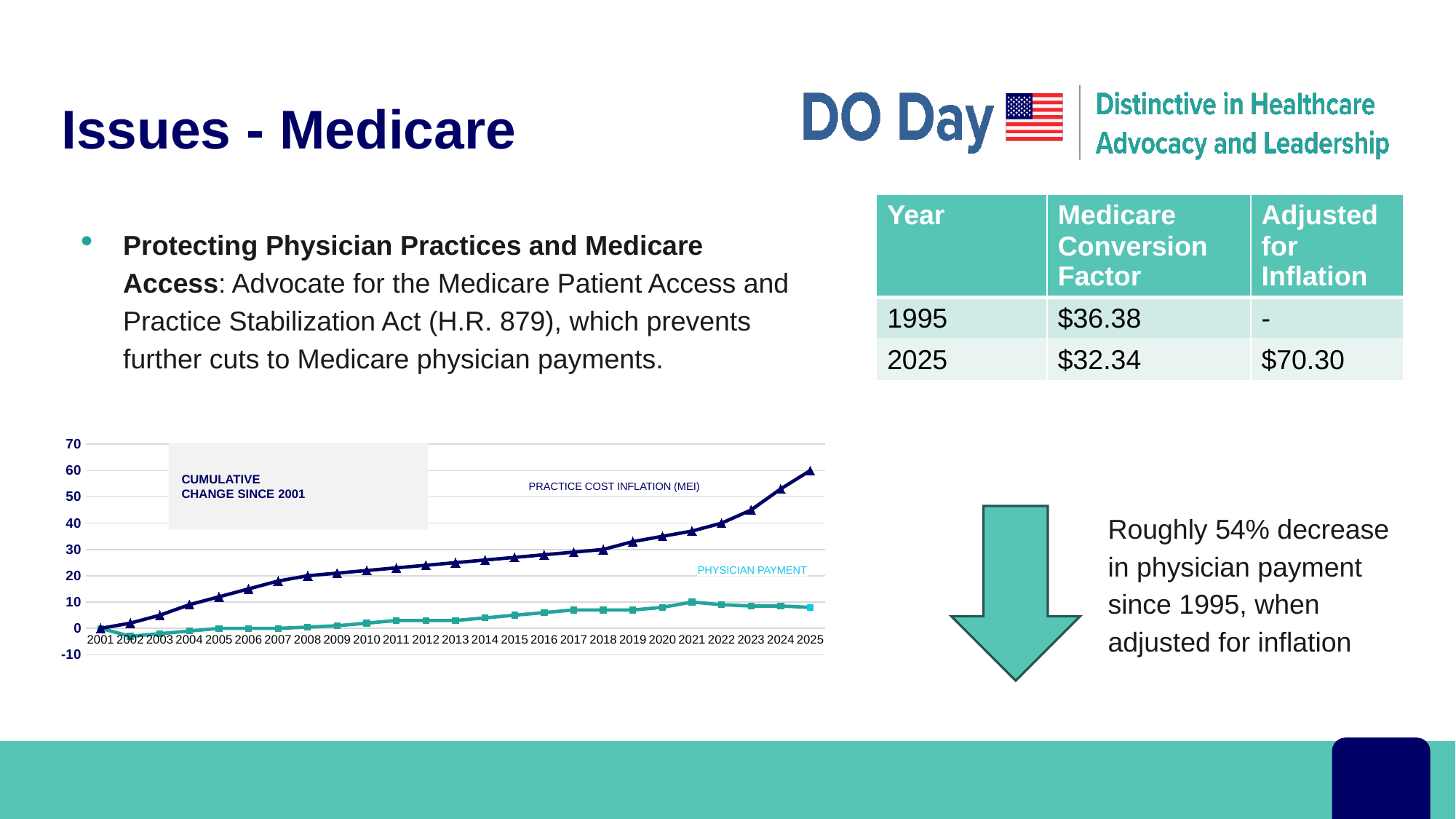
How many years are shown along the x axis of the chart? 25 In 2020, which series has the larger value, Practice Cost Inflation (MEI) or Physician Payment? Practice Cost Inflation (MEI) What is the last year shown on the x axis of the chart? 2025 What is the first year shown on the x axis of the chart? 2001 Is the Physician Payment value for 2025 greater or less than 20? less How many series are plotted in the chart? 2 In which year does the Practice Cost Inflation (MEI) line reach its highest value? 2025 What kind of chart is shown on the slide? line chart Is the Practice Cost Inflation (MEI) value for 2025 greater or less than 50? greater Does the Practice Cost Inflation (MEI) line rise or fall from 2001 to 2025? rise What are the names of the two series plotted in the chart? Practice Cost Inflation (MEI) and Physician Payment What is the title shown on the chart? CUMULATIVE CHANGE SINCE 2001